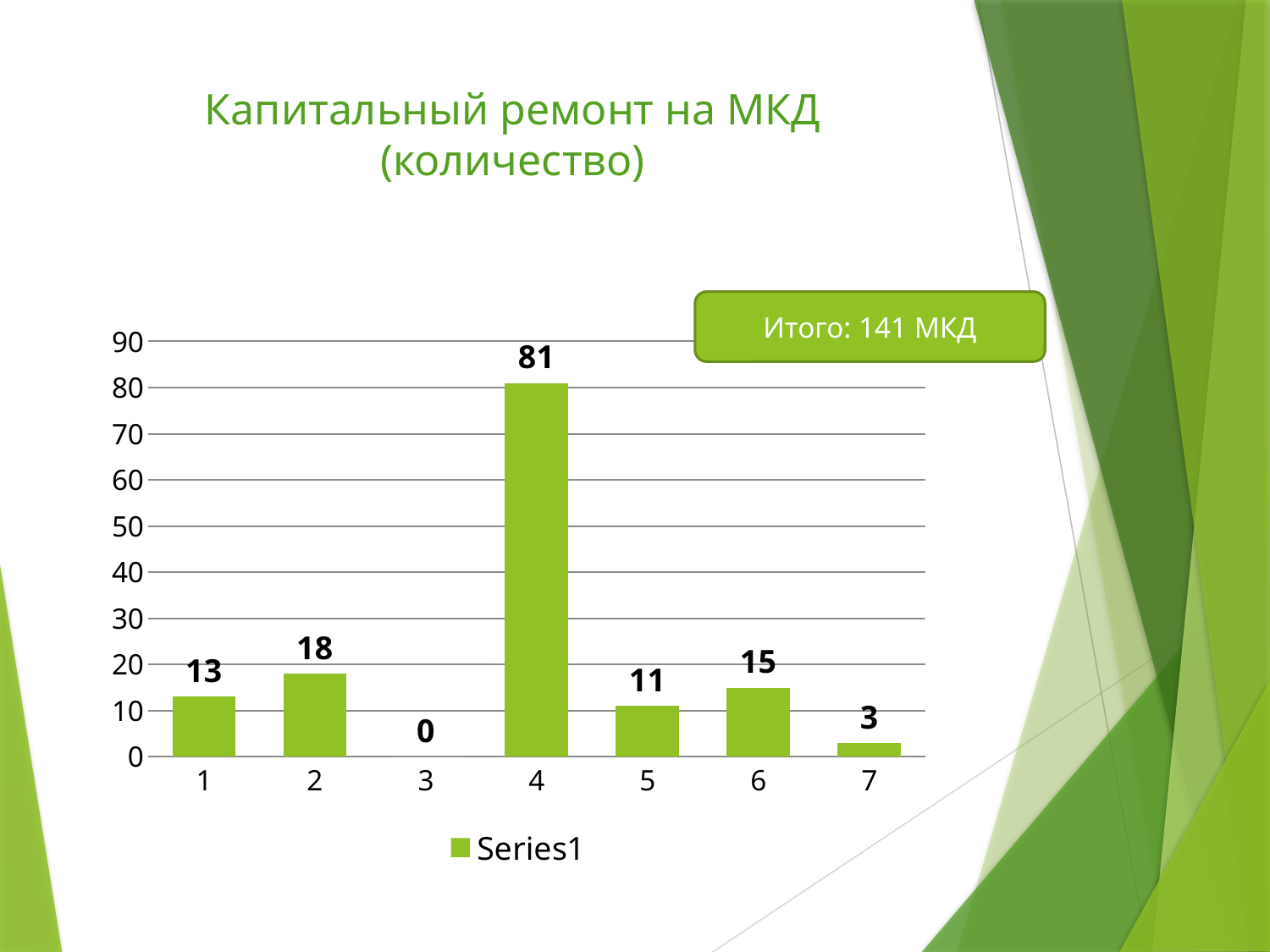
What total is stated in the callout box on the slide? Итого: 141 МКД How many categories are shown on the x axis? 7 Which category has the lowest value? 3 What kind of chart is shown on the slide? bar chart How many series does the legend list? 1 Which category has the highest value? 4 Which is larger, the value for category 1 or the value for category 6? 6 What is the value for category 4? 81 What is the value for category 2? 18 Is the value for category 4 greater or less than 70? greater What is the difference between the values for category 4 and category 2? 63 What is the value for category 7? 3